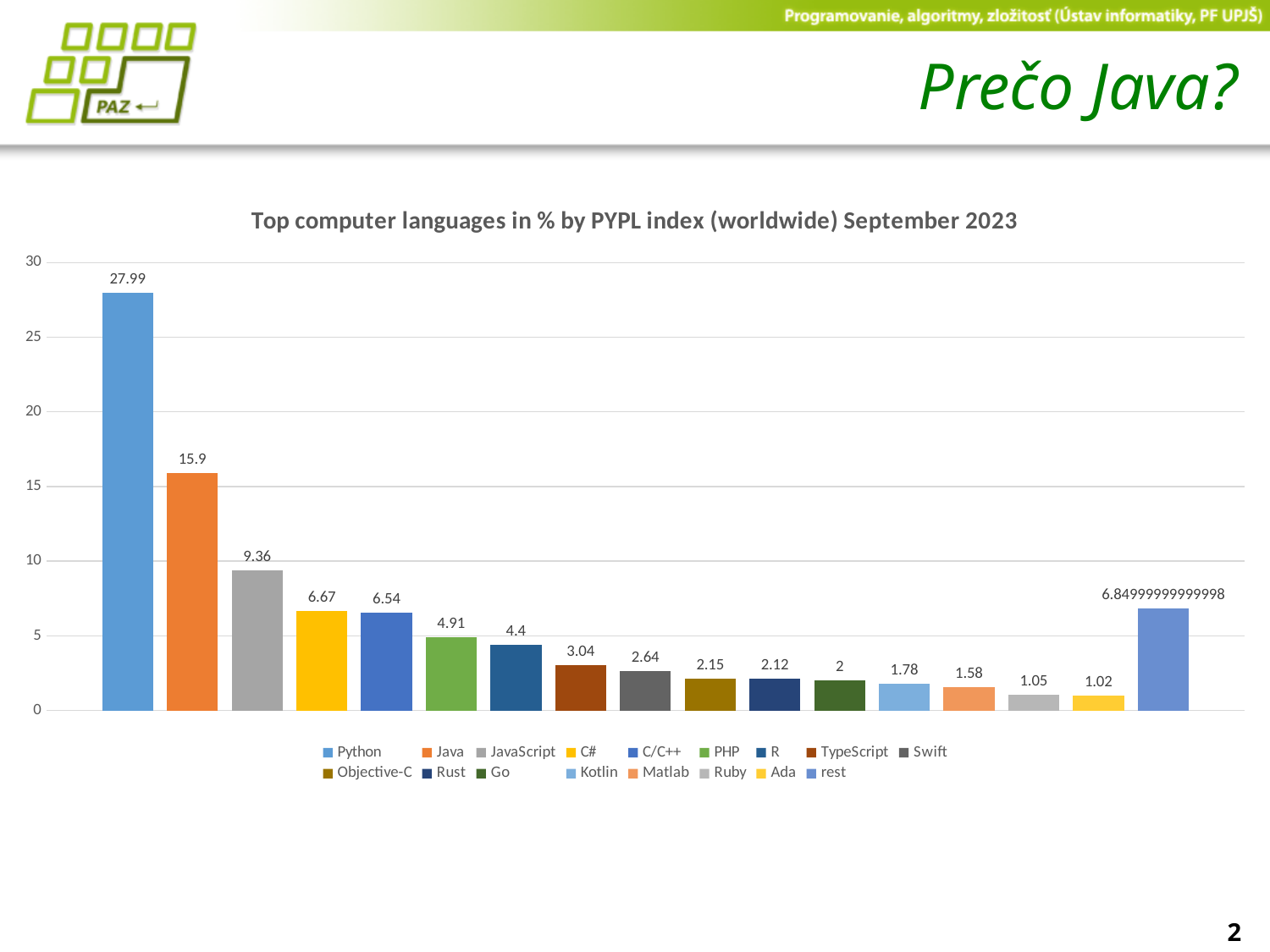
What is the value for TypeScript in the chart? 3.04 Which language has the highest value in the chart? Python What is the value for Java in the chart? 15.9 What is the value for JavaScript in the chart? 9.36 Is the value for Python greater or less than 25? greater Which has a larger value, Java or JavaScript? Java What is the difference between the values for Python and Java? 12.09 How many bars are plotted in the chart? 17 What is the title of the chart? Top computer languages in % by PYPL index (worldwide) September 2023 What kind of chart is shown on the slide? bar chart Which language has the lowest value in the chart? Ada What is the value for Python in the chart? 27.99